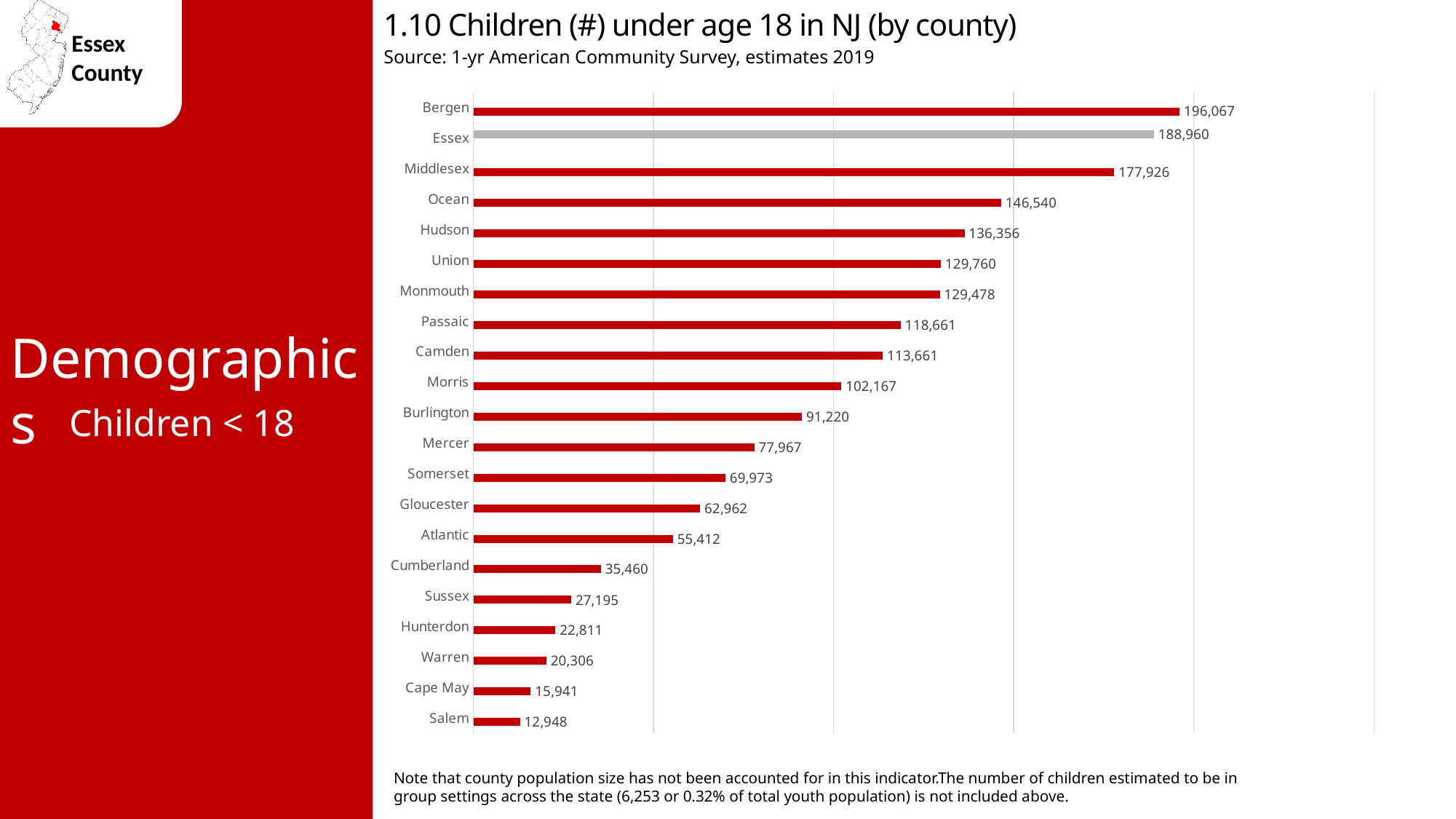
Which county has the highest number of children under age 18? Bergen Which county has the lowest number of children under age 18? Salem How many counties are plotted in the chart? 21 What is the difference between the values for Bergen and Essex? 7,107 What is the number of children under age 18 in Essex County? 188,960 What type of chart is shown on the slide? Bar chart Which county's bar is shown in grey rather than red? Essex What is the number of children under age 18 in Cumberland County? 35,460 Which has more children under age 18, Ocean or Hudson? Ocean What is the source cited under the chart title? 1-yr American Community Survey, estimates 2019 What is the number of children under age 18 in Hudson County? 136,356 What is the difference between the values for Middlesex and Ocean? 31,386